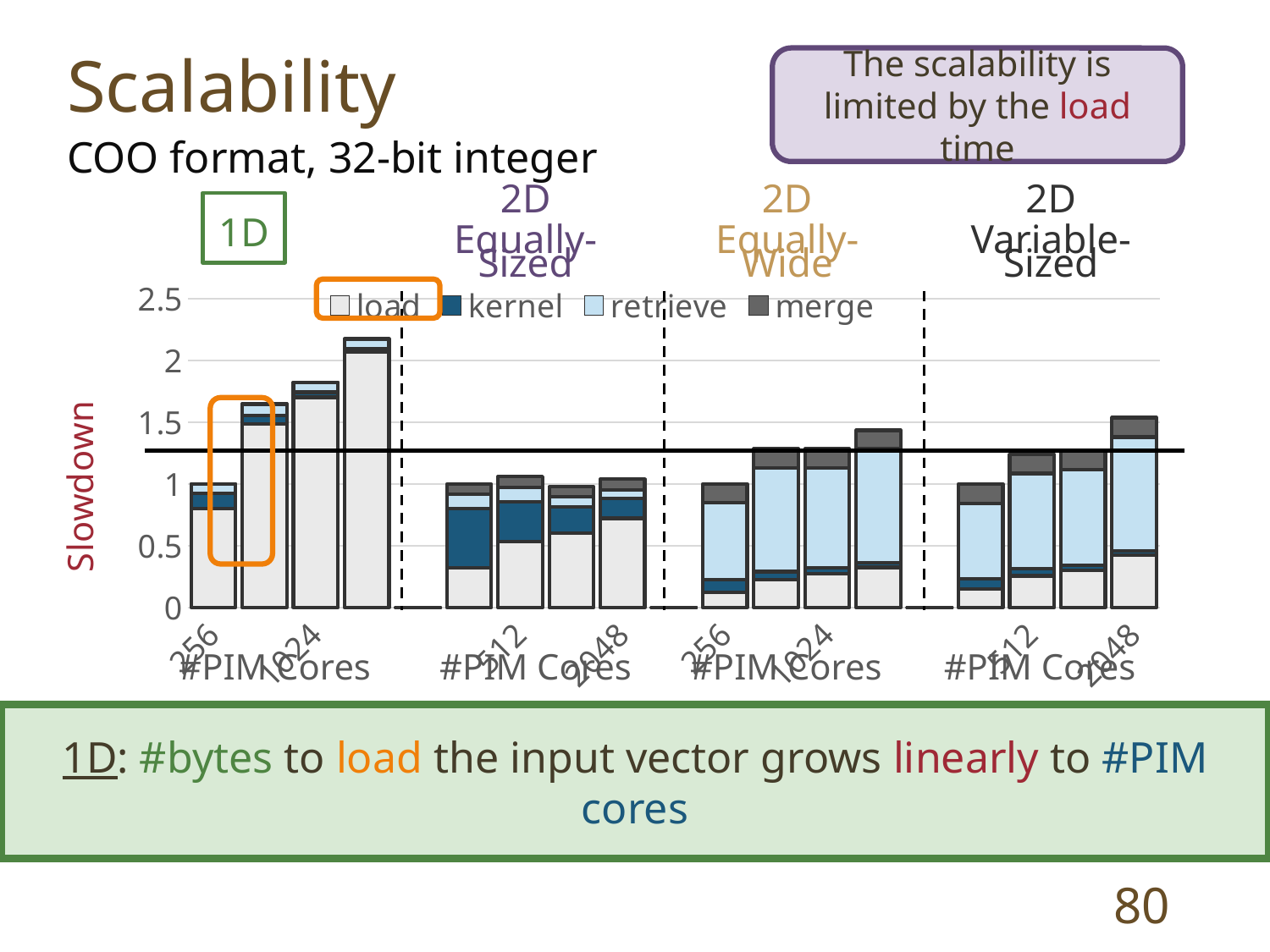
Is the total slowdown of the 1D bar at 256 PIM cores greater or less than 1.5? less Is the total slowdown of the 2D Equally-Wide bar at 2048 PIM cores greater or less than 1? greater What kind of chart is shown on the slide? stacked bar chart How many bars are plotted in the 1D group of the chart? 4 What are the four series named in the chart legend? load, kernel, retrieve, merge In the 1D group, which #PIM cores value has the tallest stacked bar? 2048 How many series does the chart legend list? 4 How many groups of bars (partitioning schemes) does the chart show? 4 Is the total slowdown of the 1D bar at 2048 PIM cores greater or less than 2? greater Which of the four groups contains the tallest stacked bar in the chart? 1D What is the label of the chart's vertical axis? Slowdown In the 1D group, do the stacked bar totals rise or fall as #PIM cores increases from 256 to 2048? rise